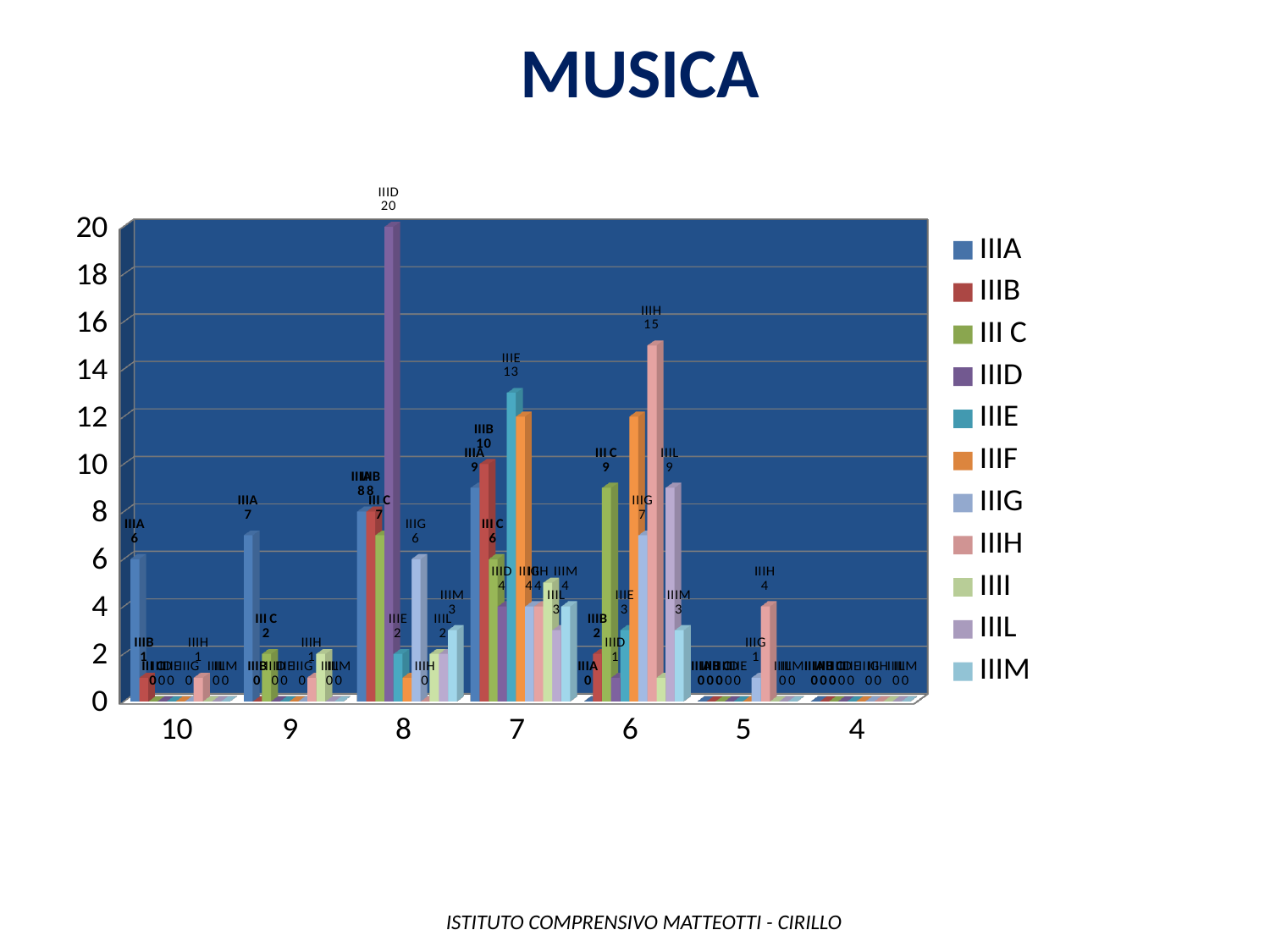
In category 7, which is larger: the value for IIIE or the value for IIIA? IIIE What is the value for IIIH in category 6? 15 What is the value for IIIA in category 9? 7 Which series has the highest value in category 8? IIID How many categories are shown on the x axis? 7 How many series does the legend list? 11 What is the title of the chart? MUSICA What is the value for IIIE in category 7? 13 Is the value for IIIF in category 7 greater or less than 10? greater What kind of chart is shown on the slide? bar chart What is the difference between the value for IIID in category 8 and the value for IIIH in category 6? 5 What is the value for IIID in category 8? 20